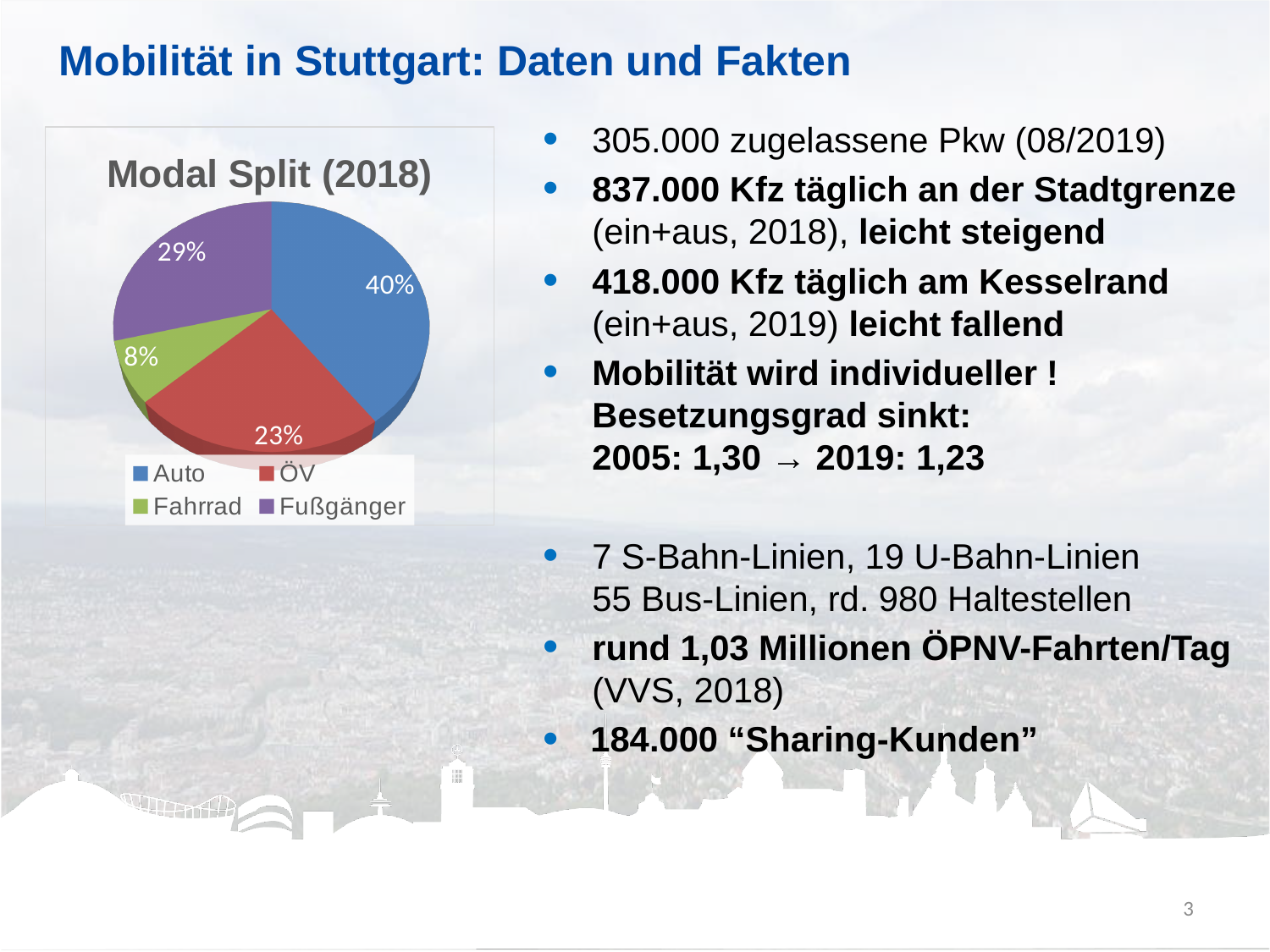
Which is larger, the share for Fußgänger or the share for ÖV? Fußgänger Which category has the smallest share of the pie? Fahrrad What kind of chart is shown on the slide? pie chart Which colour represents Fahrrad in the legend? green What is the difference in percentage points between Auto and ÖV? 17 What share of the pie does ÖV have? 23% What share of the pie does Fahrrad have? 8% How many categories does the pie chart have? 4 What is the title of the chart? Modal Split (2018) Which category has the largest share of the pie? Auto What share of the pie does Auto have? 40% What share of the pie does Fußgänger have? 29%